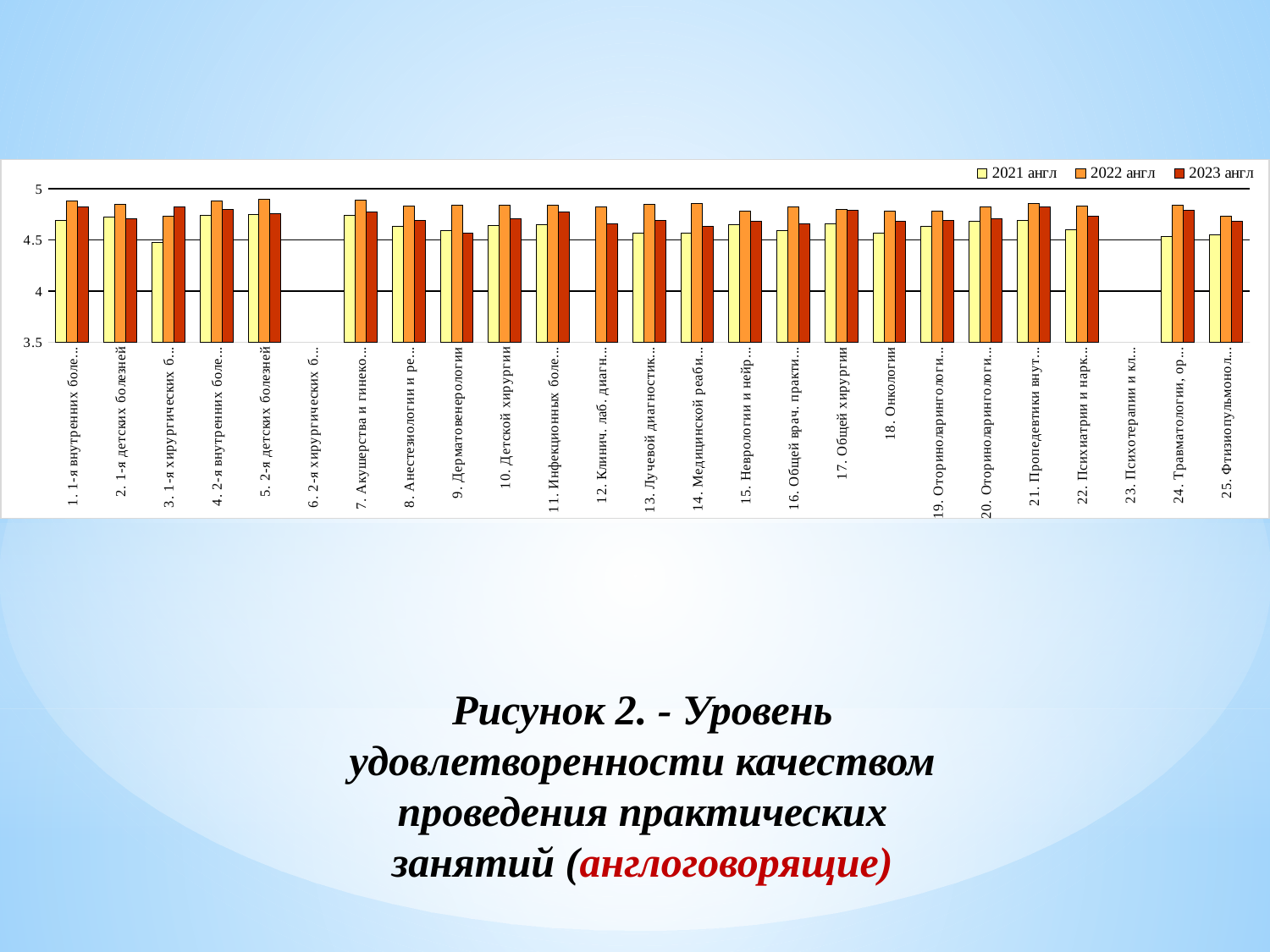
How many categories are listed along the x axis? 25 For "9. Дерматовенерологии", which is larger: the 2022 англ value or the 2023 англ value? 2022 англ Which series does the legend list first? 2021 англ Is the 2021 англ value for "18. Онкологии" greater or less than 4? greater Is the 2023 англ value for "9. Дерматовенерологии" greater or less than 5? less Is the 2022 англ value for "10. Детской хирургии" greater or less than 4.5? greater What kind of chart is shown on the slide? bar chart How many categories on the x axis have no bars plotted? 2 How many series does the legend list? 3 For "5. 2-я детских болезней", which is larger: the 2022 англ value or the 2023 англ value? 2022 англ For "3. 1-я хирургических б...", which is larger: the 2021 англ value or the 2023 англ value? 2023 англ Which series is drawn in the darkest red-orange colour? 2023 англ